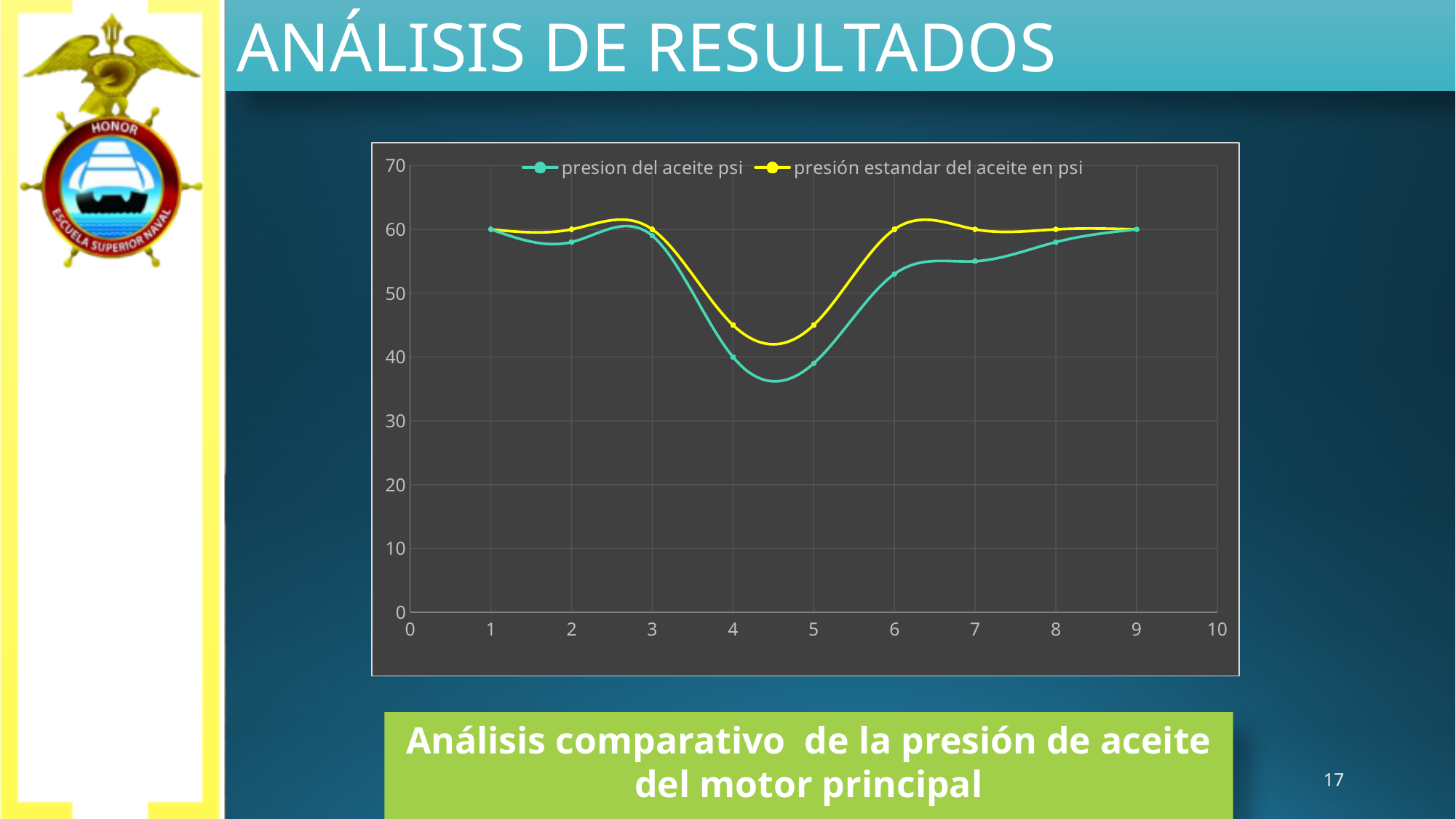
How many series does the legend list? 2 Does the 'presion del aceite psi' series rise or fall from x = 5 to x = 9? rise How many data points does the 'presion del aceite psi' series have? 9 Is the value for 'presión estandar del aceite en psi' at x = 4 greater or less than 50? less At x = 4, which series has the higher value? presión estandar del aceite en psi What kind of chart is shown on the slide? line chart Is the value for 'presion del aceite psi' at x = 6 greater or less than 50? greater Is the value for 'presion del aceite psi' at x = 5 greater or less than 50? less At x = 7, which series has the lower value? presion del aceite psi What is the value of 'presion del aceite psi' at x = 4? 40 What is the value of 'presión estandar del aceite en psi' at x = 1? 60 What colour is the line for 'presión estandar del aceite en psi'? yellow